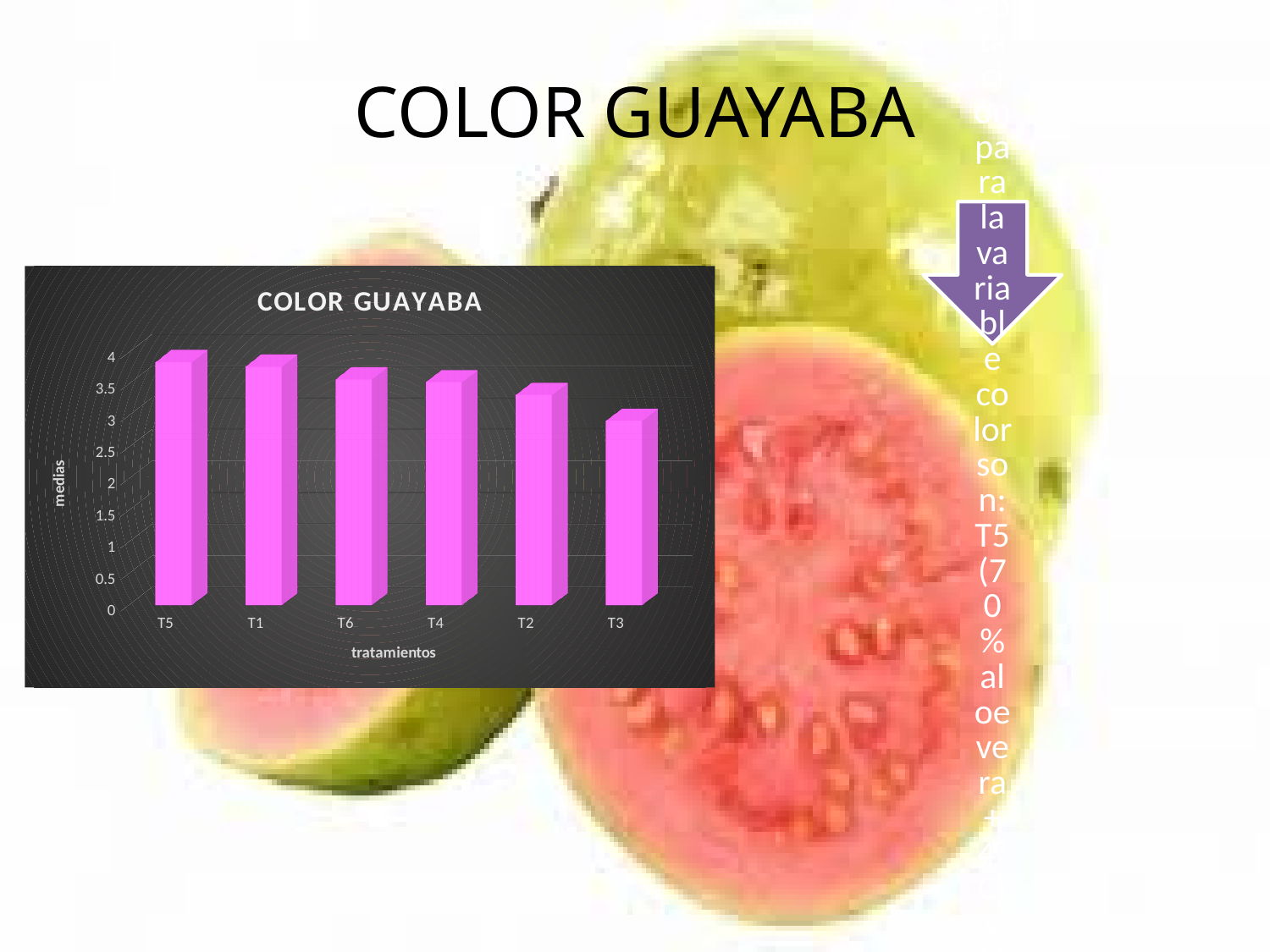
What kind of chart is shown on the slide? bar chart Which is larger, the value for T1 or the value for T2? T1 Is the value for T2 greater or less than 3? greater Which treatment has the lowest value in the chart? T3 How many treatments (categories) are plotted on the x axis of the chart? 6 Which is larger, the value for T5 or the value for T3? T5 Is the value for T5 greater or less than 3.5? greater What is the title of the chart? COLOR GUAYABA Do the bar values rise or fall moving from left to right along the x axis? fall What is the label of the vertical axis of the chart? medias Is the value for T3 greater or less than 3.5? less